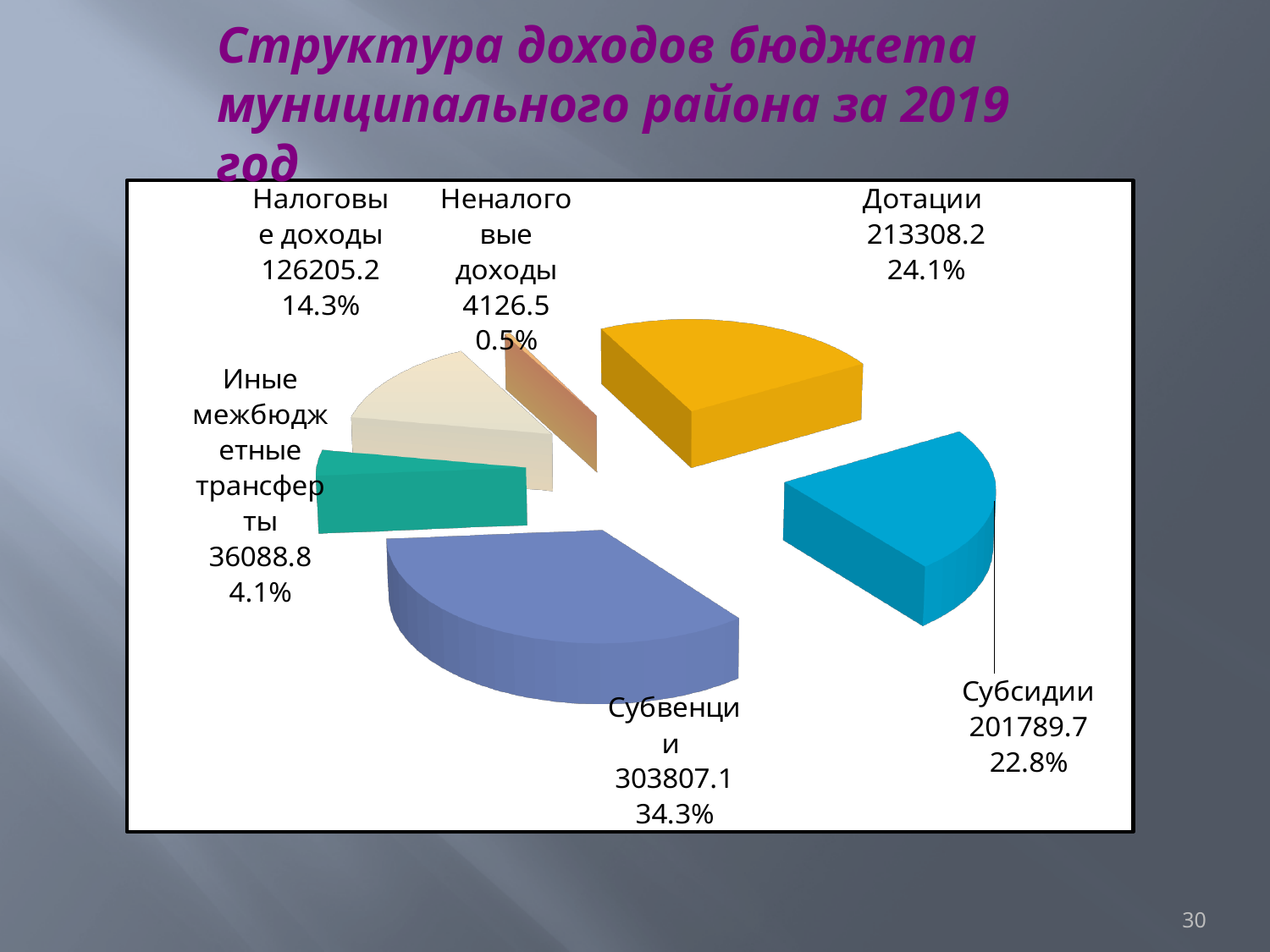
Which is larger, Дотации or Субсидии? Дотации Which category has the smallest slice of the pie? Неналоговые доходы What is the difference between the values for Дотации and Субсидии? 11518.5 What kind of chart is shown on the slide? pie chart What percentage is shown for Неналоговые доходы? 0.5% What is the value shown for Субвенции? 303807.1 What share of the pie does Дотации represent? 24.1% How many slices does the pie chart have? 6 Which category has the largest slice of the pie? Субвенции What is the title of the slide containing the chart? Структура доходов бюджета муниципального района за 2019 год What is the value shown for Иные межбюджетные трансферты? 36088.8 What is the value shown for Субсидии? 201789.7